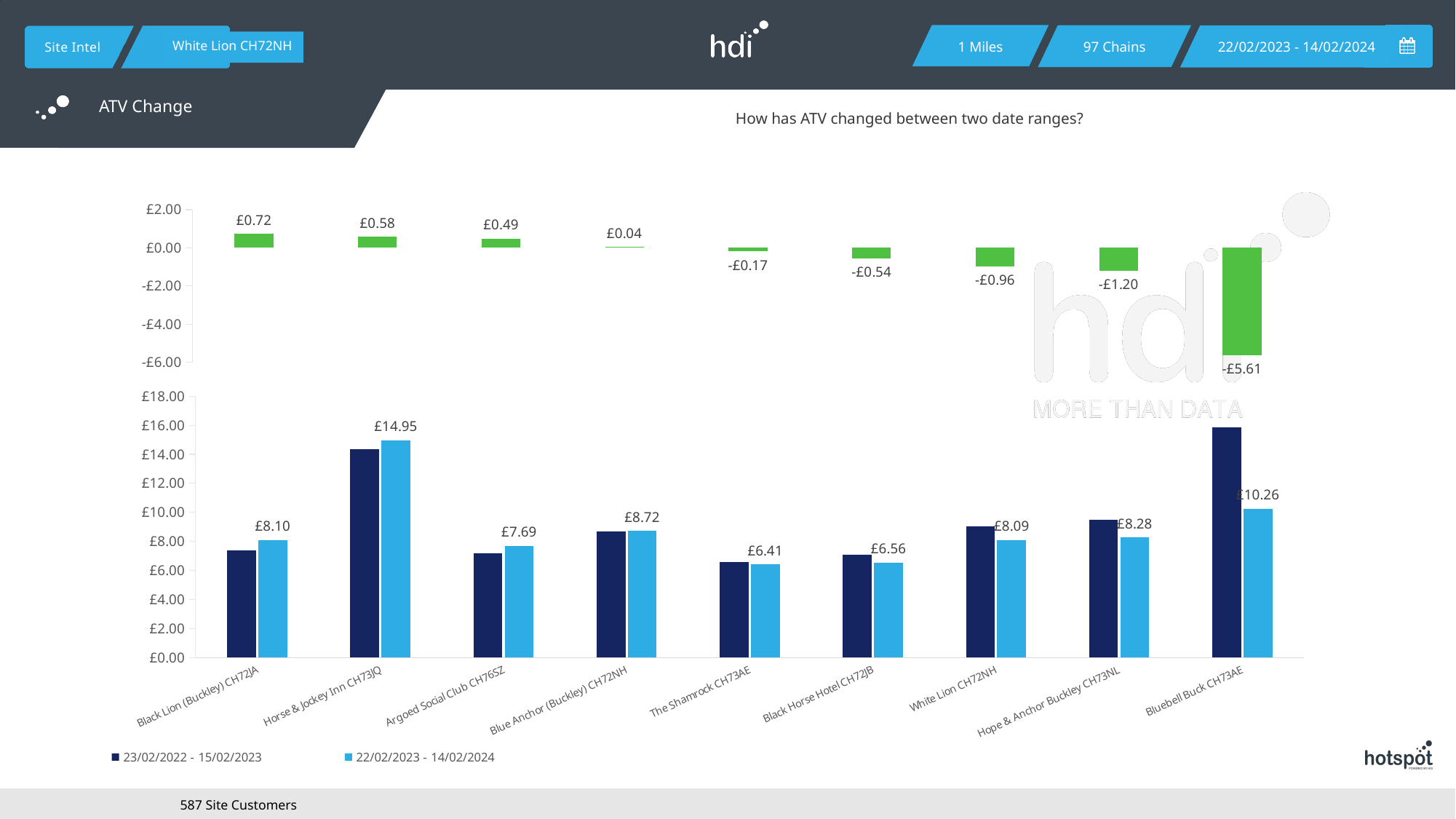
In the bottom chart, what is the value for Horse & Jockey Inn CH73JQ in the 22/02/2023 - 14/02/2024 series? £14.95 What kind of chart is the bottom chart? bar chart How many series does the legend of the bottom chart list? 2 In the bottom chart, what is the difference between the 22/02/2023 - 14/02/2024 values for Horse & Jockey Inn CH73JQ and Bluebell Buck CH73AE? £4.69 In the top chart (ATV change), what is the value for Black Lion (Buckley) CH72JA? £0.72 In the bottom chart, is the 23/02/2022 - 15/02/2023 value for Bluebell Buck CH73AE greater or less than £14.00? greater How many sites are shown on the x axis of the bottom chart? 9 In the top chart (ATV change), what is the value for Hope & Anchor Buckley CH73NL? -£1.20 In the bottom chart, which site has the lowest value in the 22/02/2023 - 14/02/2024 series? The Shamrock CH73AE In the top chart (ATV change), what is the difference between the values for Black Lion (Buckley) CH72JA and Horse & Jockey Inn CH73JQ? £0.14 In the top chart (ATV change), which site has the highest value? Black Lion (Buckley) CH72JA In the top chart (ATV change), which site has the lowest value? Bluebell Buck CH73AE